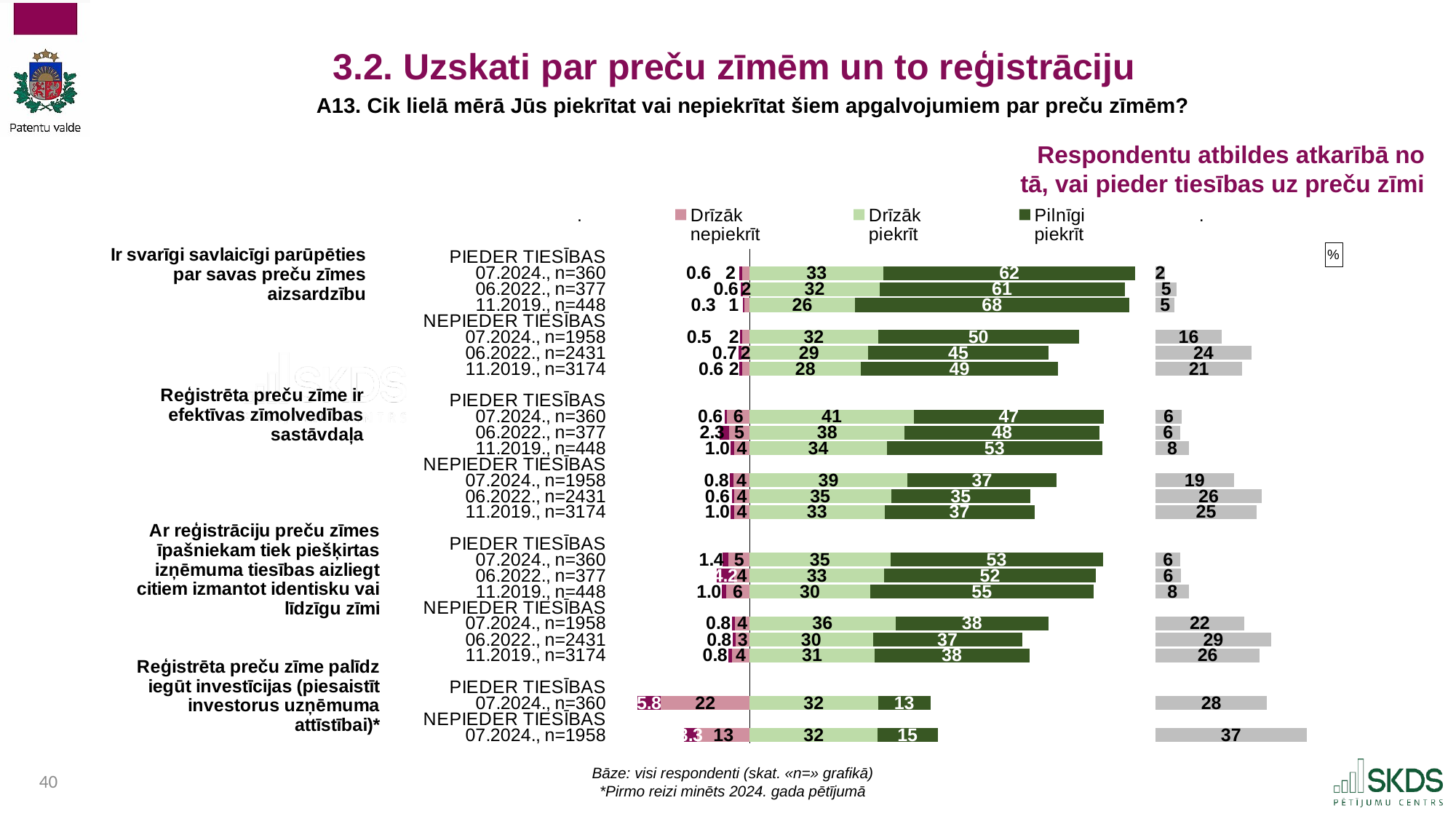
How many statements about trademarks are shown in the chart? 4 For the statement "Reģistrēta preču zīme palīdz iegūt investīcijas", what is the "Drīzāk nepiekrīt" value for NEPIEDER TIESĪBAS 07.2024., n=1958? 13 For the statement "Reģistrēta preču zīme palīdz iegūt investīcijas", which group has the larger "Pilnīgi piekrīt" value: PIEDER TIESĪBAS or NEPIEDER TIESĪBAS? NEPIEDER TIESĪBAS For the statement "Ar reģistrāciju preču zīmes īpašniekam tiek piešķirtas izņēmuma tiesības...", what is the "Pilnīgi piekrīt" value for PIEDER TIESĪBAS 11.2019., n=448? 55 For the statement "Ir svarīgi savlaicīgi parūpēties par savas preču zīmes aizsardzību", which row has the highest "Pilnīgi piekrīt" value? PIEDER TIESĪBAS 11.2019., n=448 What value is shown on the grey bar for "Reģistrēta preču zīme palīdz iegūt investīcijas", NEPIEDER TIESĪBAS 07.2024., n=1958? 37 For the statement "Ir svarīgi savlaicīgi parūpēties par savas preču zīmes aizsardzību", what is the "Drīzāk piekrīt" value for NEPIEDER TIESĪBAS 11.2019., n=3174? 28 For the statement "Reģistrēta preču zīme ir efektīvas zīmolvedības sastāvdaļa", what is the "Drīzāk piekrīt" value for NEPIEDER TIESĪBAS 06.2022., n=2431? 35 For the statement "Reģistrēta preču zīme ir efektīvas zīmolvedības sastāvdaļa", PIEDER TIESĪBAS 07.2024., n=360, which is larger: "Drīzāk piekrīt" or "Pilnīgi piekrīt"? Pilnīgi piekrīt For the statement "Ir svarīgi savlaicīgi parūpēties par savas preču zīmes aizsardzību", what is the "Pilnīgi piekrīt" value for PIEDER TIESĪBAS 07.2024., n=360? 62 What type of chart is shown on the slide? Stacked horizontal bar chart For the statement "Ir svarīgi savlaicīgi parūpēties par savas preču zīmes aizsardzību", what is the difference between the "Pilnīgi piekrīt" values for PIEDER TIESĪBAS 07.2024. and NEPIEDER TIESĪBAS 07.2024.? 12